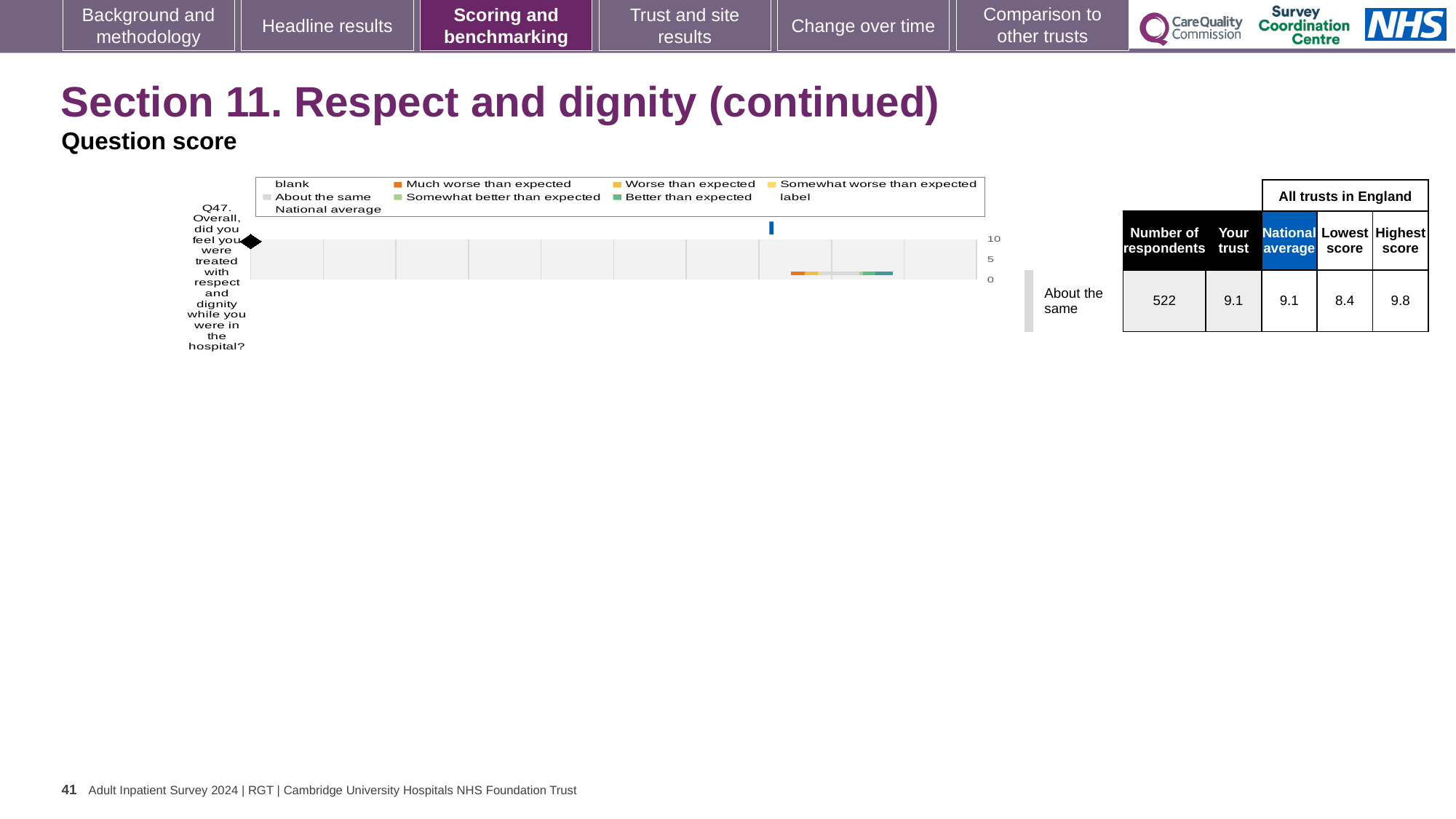
Is the trust's score for Q47 (9.1) larger than, smaller than, or equal to the national average (9.1)? equal According to the table beside the chart, what is the lowest score among all trusts in England for Q47? 8.4 What is the difference between the highest score (9.8) and the lowest score (8.4) shown in the table beside the chart? 1.4 What is the highest tick value shown on the chart's axis? 10 According to the table beside the chart, what is the 'Your trust' score for Q47? 9.1 What benchmark category is the trust's Q47 result labelled as on the slide? About the same What kind of chart is shown on the slide? bar chart How many questions (categories) are plotted on the chart? 1 According to the table beside the chart, what is the highest score among all trusts in England for Q47? 9.8 According to the table beside the chart, what is the number of respondents for Q47? 522 Which question is plotted on the chart? Q47. Overall, did you feel you were treated with respect and dignity while you were in the hospital?